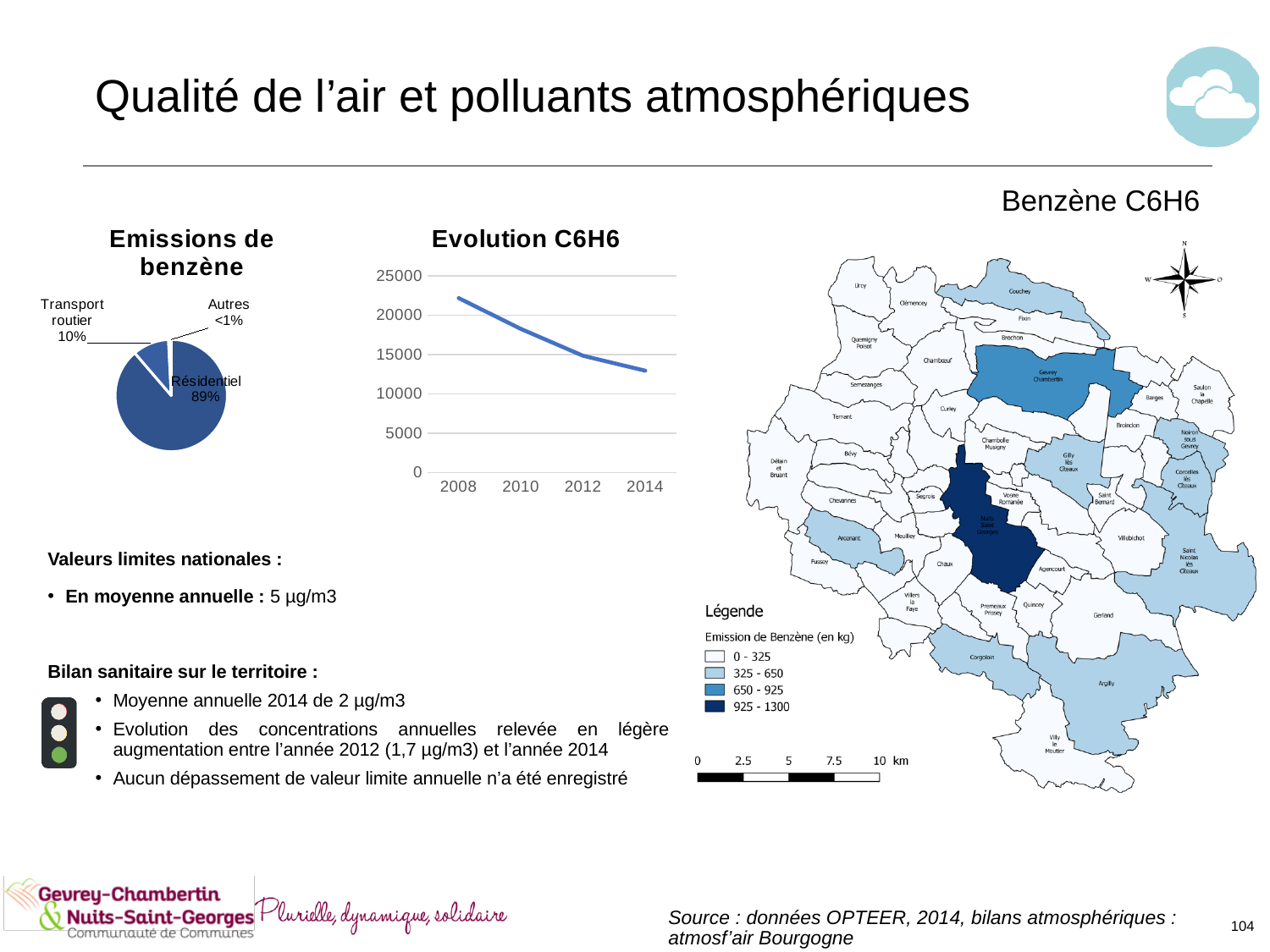
In the 'Emissions de benzène' chart, which category has the largest share? Résidentiel In the 'Emissions de benzène' chart, what share is shown for Autres? <1% What kind of chart is 'Evolution C6H6'? Line chart In the 'Emissions de benzène' chart, what share of benzene emissions comes from Résidentiel? 89% In the 'Emissions de benzène' chart, what share of benzene emissions comes from Transport routier? 10% In the 'Evolution C6H6' chart, is the value for 2014 greater or less than 15000? less In the 'Evolution C6H6' chart, which year has the highest value? 2008 In the 'Evolution C6H6' chart, do the values rise or fall from 2008 to 2014? Fall In the 'Evolution C6H6' chart, is the value for 2008 greater or less than 20000? greater What kind of chart is 'Emissions de benzène'? Pie chart In the 'Emissions de benzène' chart, how many categories are shown? 3 In the 'Emissions de benzène' chart, which category has the smallest share? Autres